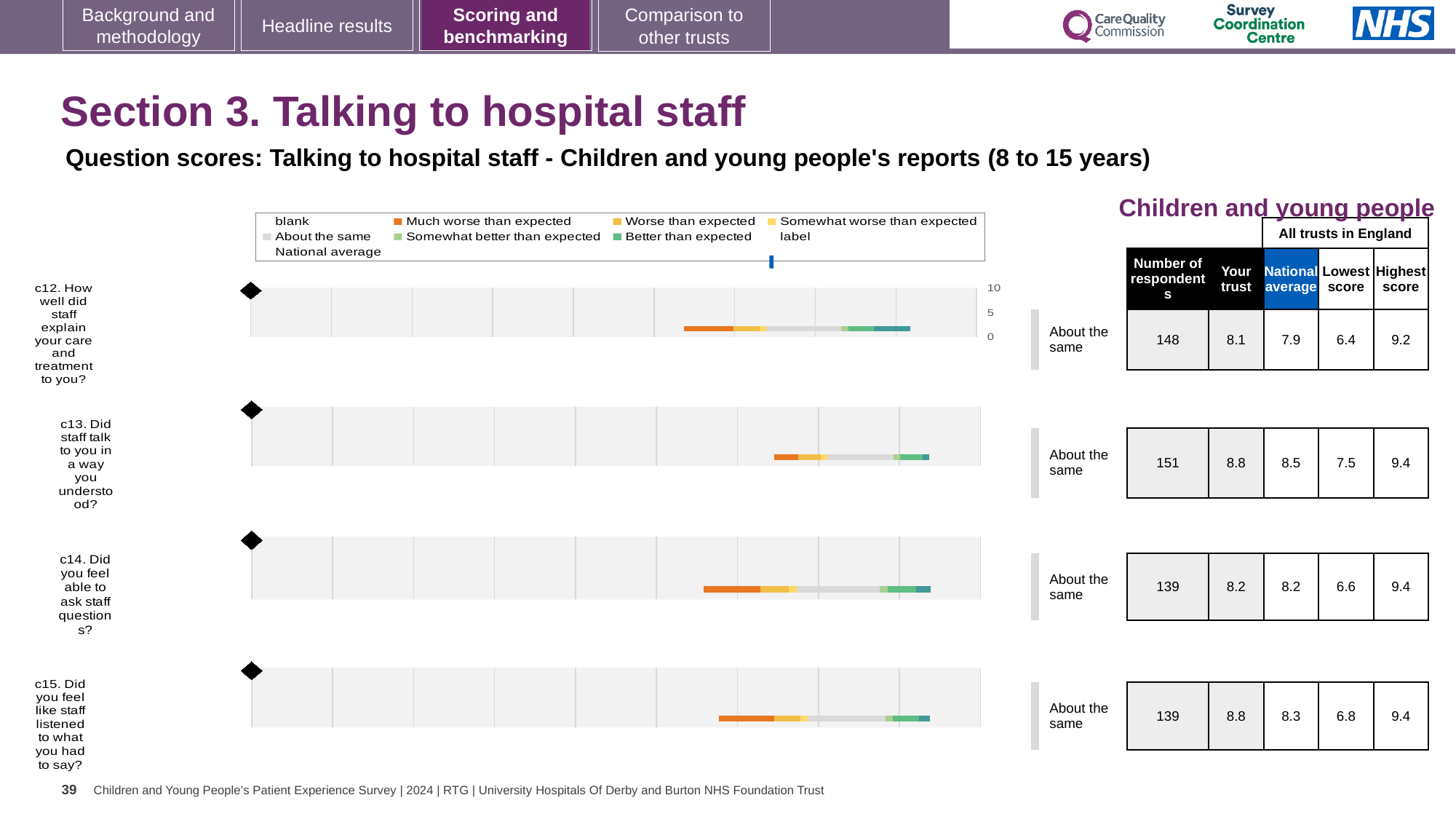
What benchmark label is given for c14 (Did you feel able to ask staff questions?)? About the same What is the highest score among all trusts in England for c15 (Did you feel like staff listened to what you had to say?)? 9.4 For c13, what is the difference between the 'Your trust' score and the national average? 0.3 Which question has the lowest 'Your trust' score on this slide? c12 What is the lowest score among all trusts in England for c12? 6.4 Which question has the highest number of respondents? c13 What kind of chart is used to show the question scores on this slide? Bar chart How many respondents answered c14 (Did you feel able to ask staff questions?)? 139 What is the 'Your trust' score for c12 (How well did staff explain your care and treatment to you?)? 8.1 What is the national average score for c13 (Did staff talk to you in a way you understood?)? 8.5 How many questions (charts) are shown on this slide? 4 For c15, which is larger: the 'Your trust' score or the national average? Your trust